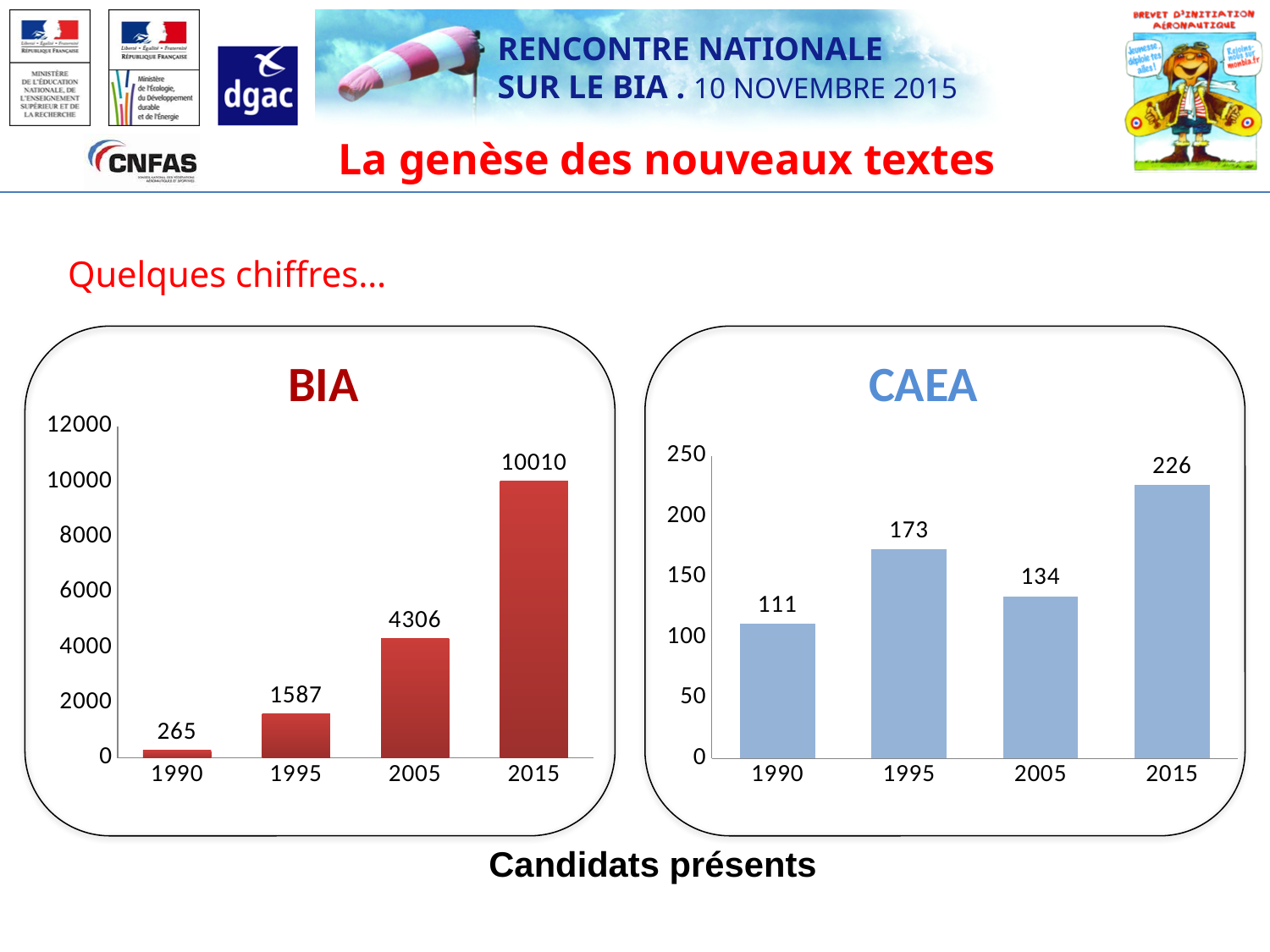
In the CAEA chart, what is the difference between the values for 1995 and 2005? 39 In the BIA chart, what is the difference between the values for 2015 and 2005? 5704 In the BIA chart, do the values rise or fall from 1990 to 2015? rise In the CAEA chart, which year has the highest value? 2015 In the CAEA chart, which is larger, the value for 1995 or the value for 2005? 1995 In the CAEA chart, which year has the lowest value? 1990 In the BIA chart, which year has the lowest value? 1990 In the CAEA chart, what is the value for 1995? 173 What kind of chart is the CAEA chart? bar chart How many years are shown on the x axis of the BIA chart? 4 In the BIA chart, what is the value for 2015? 10010 In the BIA chart, is the value for 2005 greater or less than 4000? greater